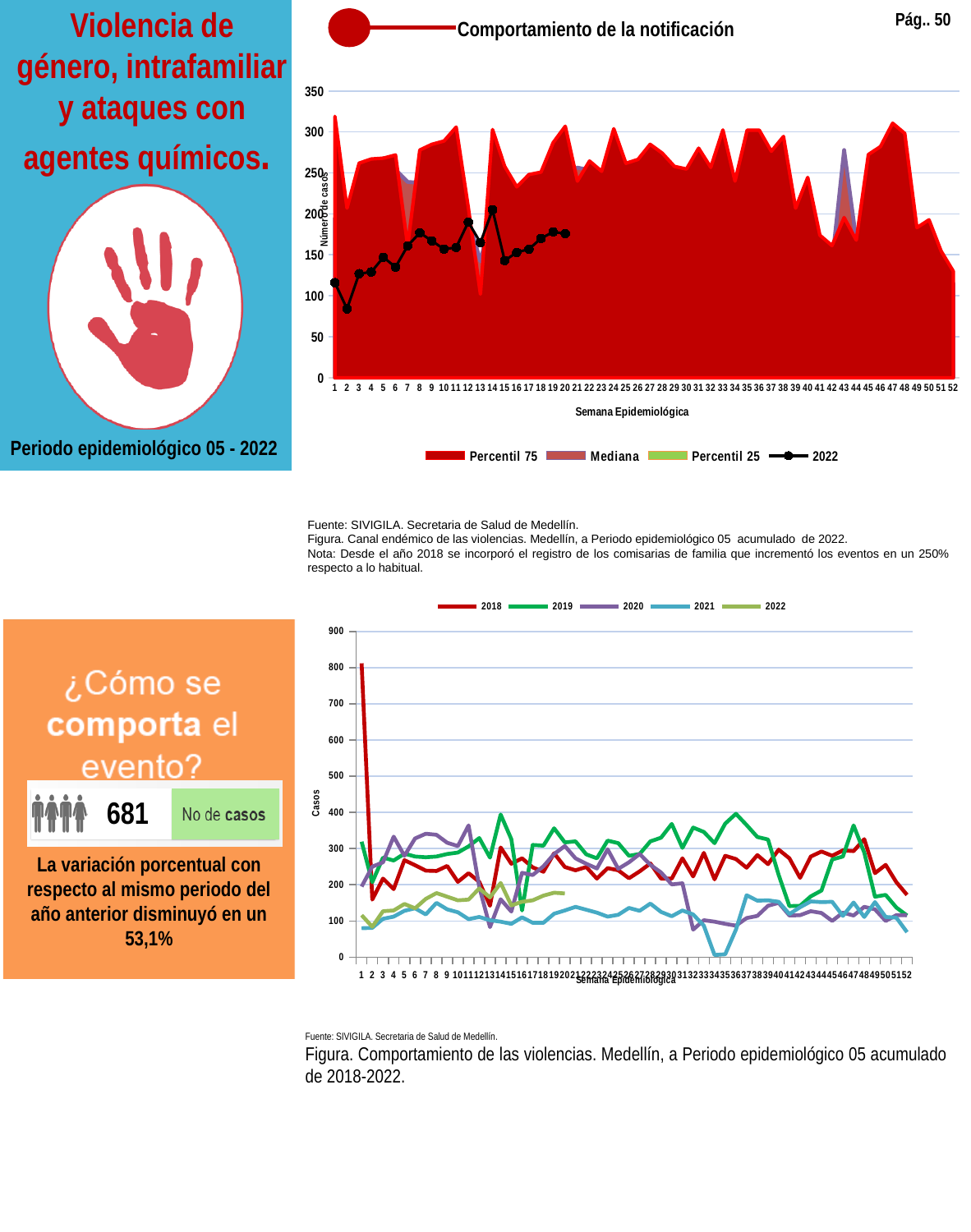
In the top chart 'Comportamiento de la notificación', how many series does the legend list? 4 In the top chart 'Comportamiento de la notificación', how many epidemiological weeks are shown on the x axis? 52 In the bottom chart showing the years 2018 to 2022, is the 2018 value at week 1 greater or less than 700? greater What type of chart is the bottom chart showing the years 2018 to 2022? line chart In the top chart 'Comportamiento de la notificación', is the Percentil 75 value at week 1 greater or less than 300? greater In the top chart 'Comportamiento de la notificación', which is larger for the 2022 series: the value at week 2 or the value at week 14? week 14 In the bottom chart showing the years 2018 to 2022, is the 2021 value at week 35 greater or less than 100? less What type of chart is the top chart titled 'Comportamiento de la notificación'? area chart with a line In the bottom chart showing the years 2018 to 2022, how many series does the legend list? 5 In the top chart 'Comportamiento de la notificación', what is the label of the x axis? Semana Epidemiológica In the top chart 'Comportamiento de la notificación', does the 2022 line generally rise or fall from week 2 to week 20? rise